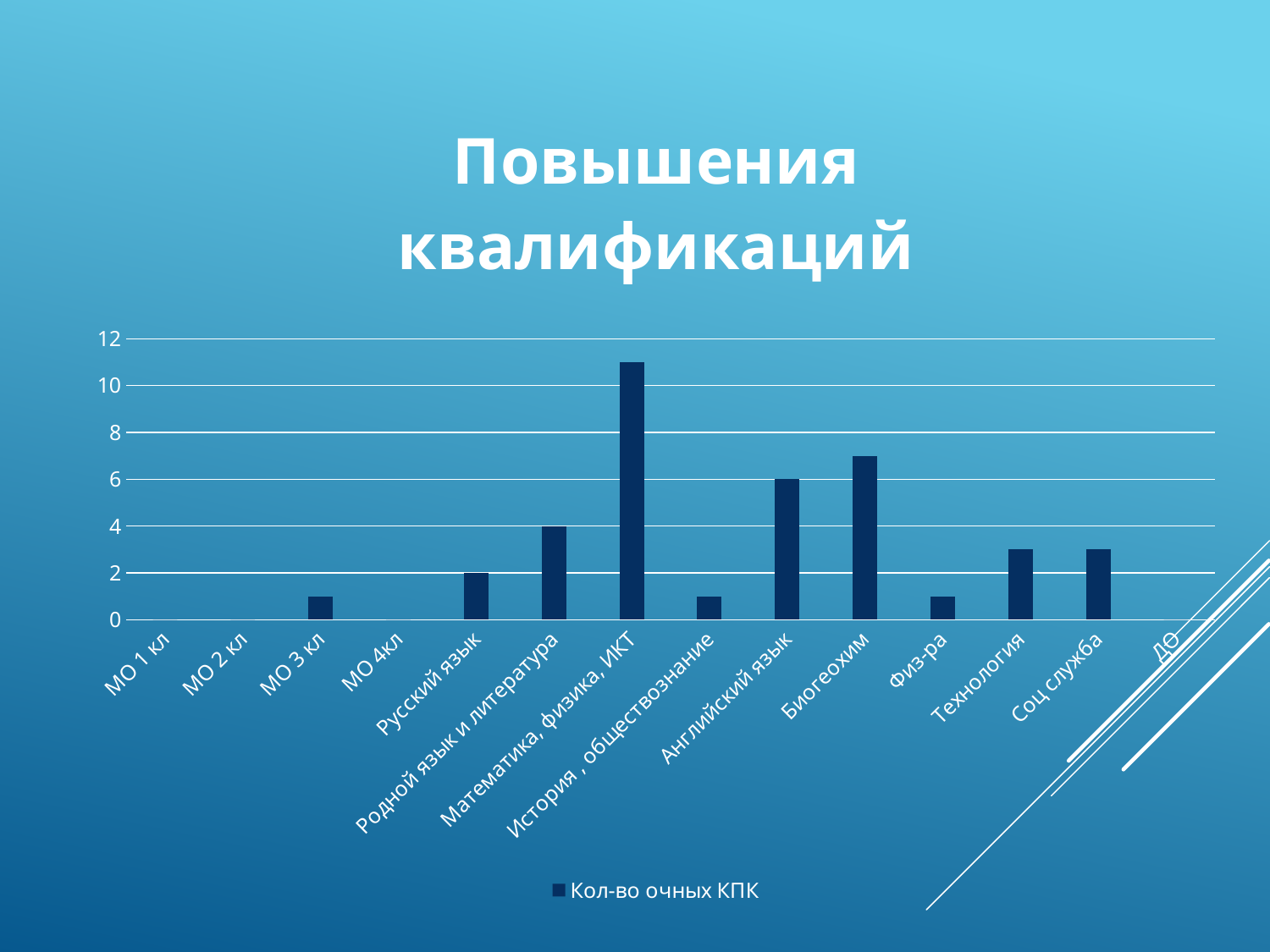
What series does the legend list? Кол-во очных КПК What is the title of the slide? Повышения квалификаций What is the value for Русский язык? 2 What is the difference between the values for Английский язык and Русский язык? 4 Is the value for Математика, физика, ИКТ greater or less than 10? greater What is the value for Английский язык? 6 Which category has the highest value? Математика, физика, ИКТ How many categories are shown on the x axis? 14 How many series does the legend list? 1 What type of chart is shown on the slide? bar chart What is the value for Родной язык и литература? 4 Which is larger, the value for Родной язык и литература or the value for Русский язык? Родной язык и литература